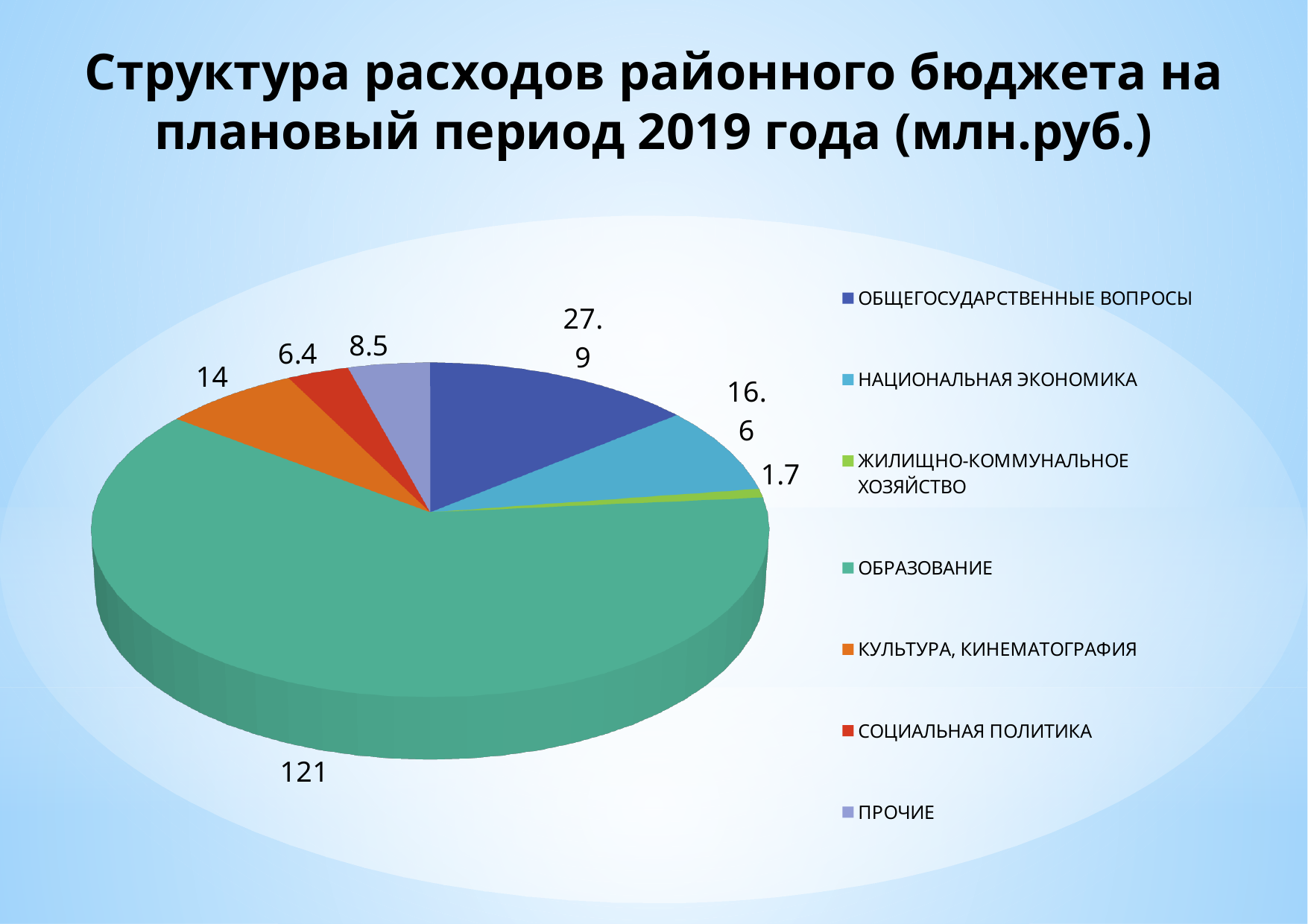
What is the value for СОЦИАЛЬНАЯ ПОЛИТИКА? 6.4 What is the title of the chart on the slide? Структура расходов районного бюджета на плановый период 2019 года (млн.руб.) What is the difference between the values for ОБРАЗОВАНИЕ and ОБЩЕГОСУДАРСТВЕННЫЕ ВОПРОСЫ? 93.1 What type of chart is shown on the slide? Pie chart Which is larger: КУЛЬТУРА, КИНЕМАТОГРАФИЯ or ПРОЧИЕ? КУЛЬТУРА, КИНЕМАТОГРАФИЯ What is the value for ОБЩЕГОСУДАРСТВЕННЫЕ ВОПРОСЫ? 27.9 What is the value for ОБРАЗОВАНИЕ? 121 How many categories does the pie chart have? 7 What is the value for НАЦИОНАЛЬНАЯ ЭКОНОМИКА? 16.6 What is the value for ЖИЛИЩНО-КОММУНАЛЬНОЕ ХОЗЯЙСТВО? 1.7 Which category has the largest slice of the pie? ОБРАЗОВАНИЕ Which category has the smallest slice of the pie? ЖИЛИЩНО-КОММУНАЛЬНОЕ ХОЗЯЙСТВО